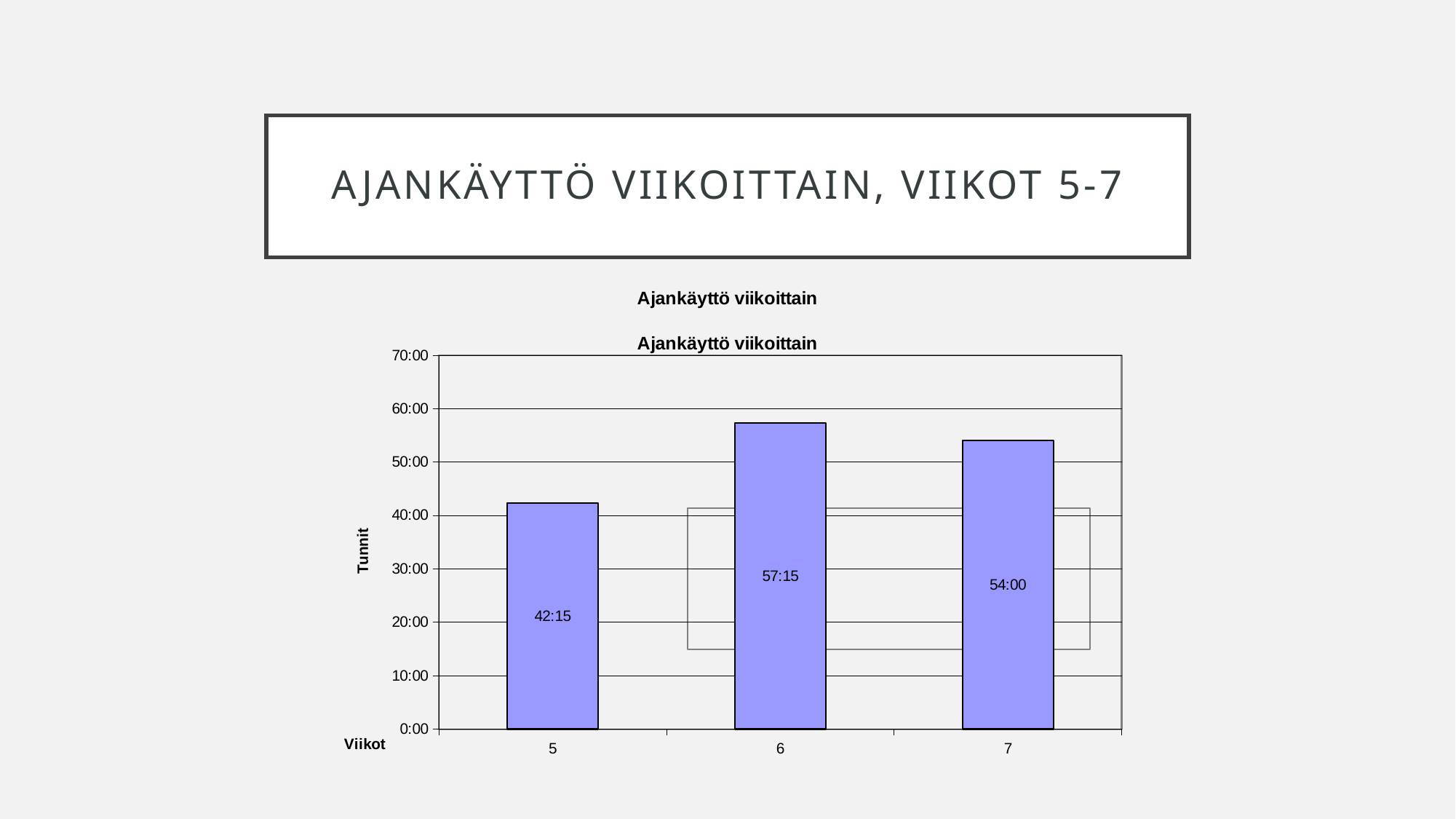
How many weeks are shown on the x axis of the chart? 3 What is the value for week 7 in the chart? 54:00 Is the value for week 5 greater or less than 50:00? less What is the difference between the values for week 6 and week 7? 3:15 What is the value for week 5 in the chart? 42:15 What is the label of the y axis of the chart? Tunnit Which week has the lowest value in the chart? 5 Which is larger, the value for week 7 or the value for week 5? week 7 What is the value for week 6 in the chart? 57:15 Which week has the highest value in the chart? 6 What kind of chart is shown on the slide? bar chart What is the difference between the values for week 6 and week 5? 15:00